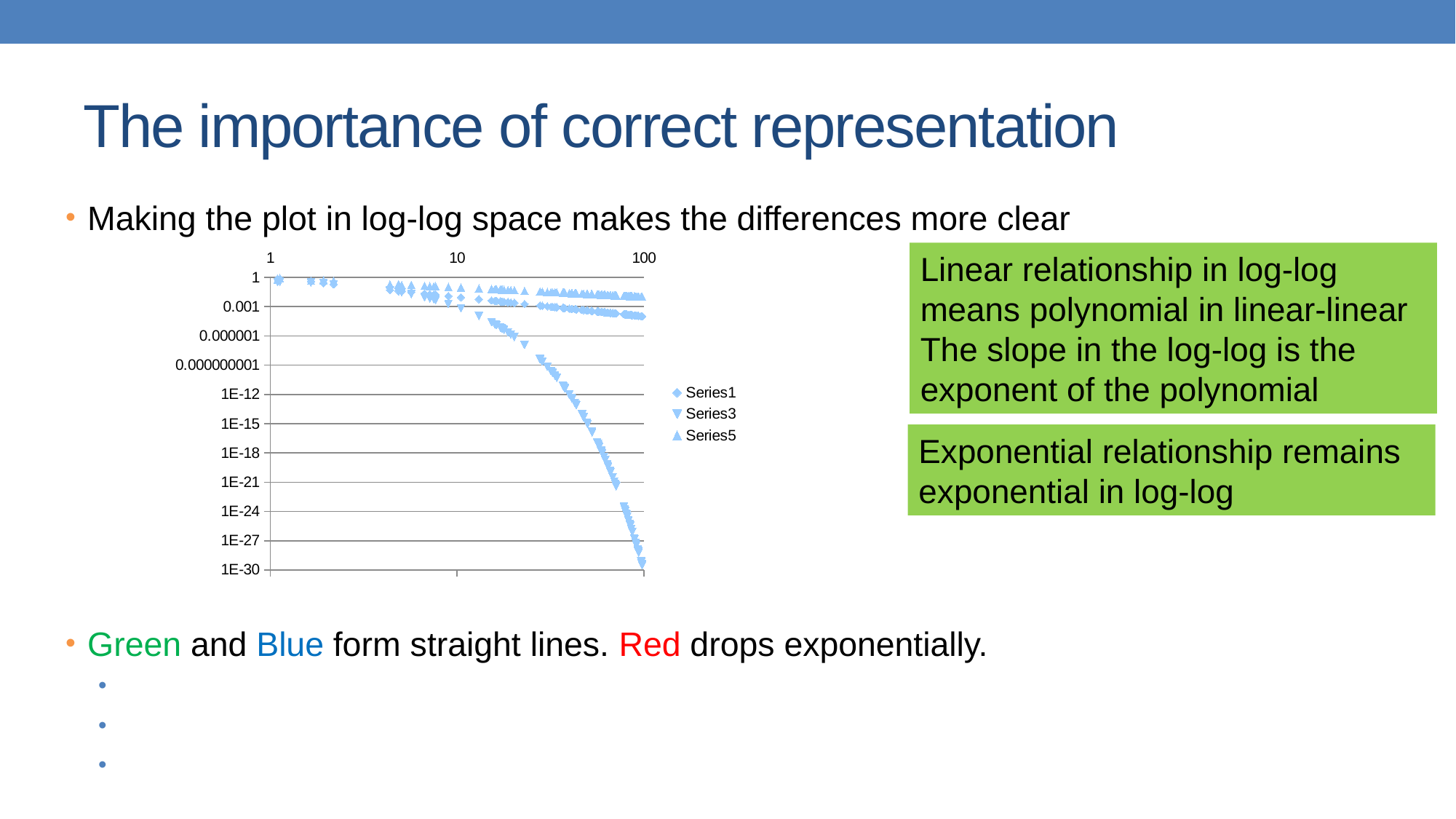
Which series drops most steeply as x increases toward 100? Series3 What are the names of the series listed in the chart legend? Series1, Series3, Series5 Which series has the lowest value at x = 100? Series3 At x = 100, which is larger, the value for Series1 or the value for Series5? Series5 Is the value for Series3 at x = 100 greater or less than 1E-21? less Is the value for Series1 at x = 100 greater or less than 0.001? less What is the lowest tick label shown on the chart's y axis? 1E-30 How many series does the chart legend list? 3 Do the values of Series3 rise or fall as x increases along the x axis? fall Which series has the highest value at x = 100? Series5 Is the value for Series5 at x = 100 greater or less than 0.000001? greater What kind of chart is shown on the slide? scatter chart